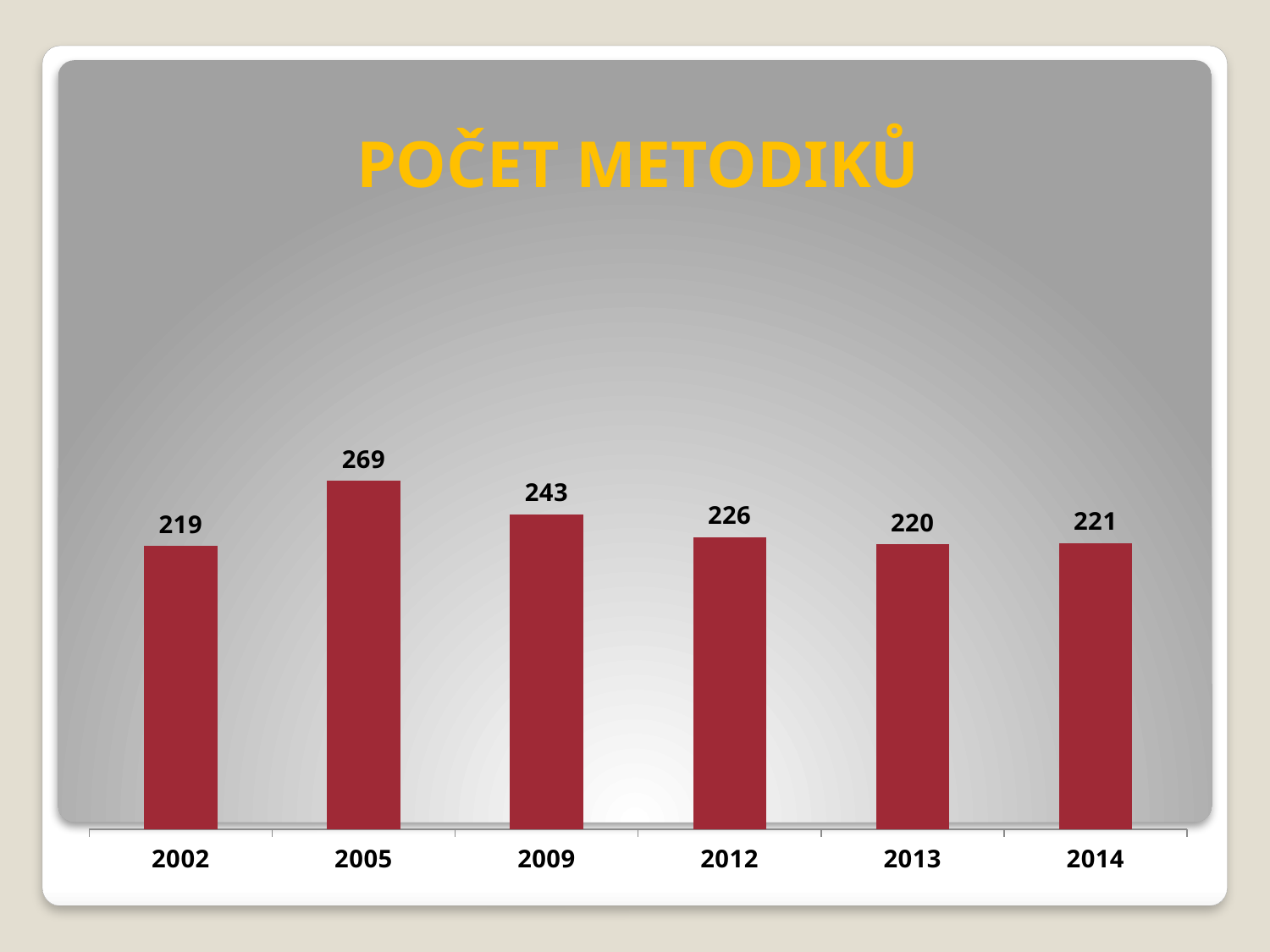
What is the title of the chart? POČET METODIKŮ Do the values rise or fall from 2005 to 2013? fall What is the value for 2005? 269 Which year has the highest value? 2005 What kind of chart is shown on the slide? bar chart What is the difference between the values for 2005 and 2002? 50 What is the value for 2014? 221 Which is larger, the value for 2009 or the value for 2013? 2009 What is the value for 2012? 226 Which year has the lowest value? 2002 What is the difference between the values for 2009 and 2012? 17 How many years are shown on the x axis? 6